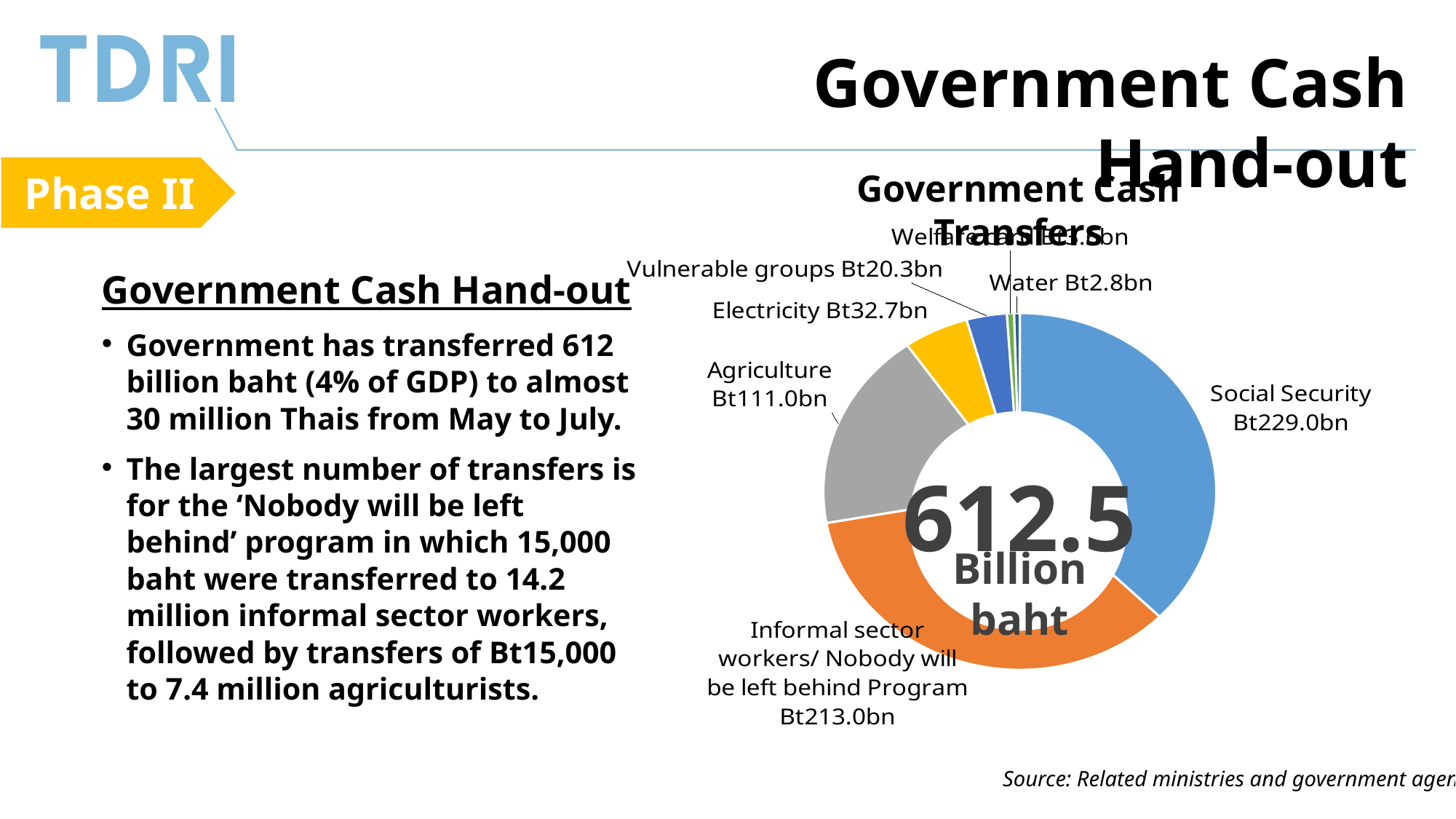
What is the value for Agriculture in the chart? Bt111.0bn What is the value for Electricity in the chart? Bt32.7bn What is the difference between Social Security and the Informal sector workers/ Nobody will be left behind Program? Bt16.0bn What is the value for Vulnerable groups in the chart? Bt20.3bn What type of chart is shown on the slide? Doughnut (pie) chart What is the title of the chart? Government Cash Transfers What is the value for Social Security in the chart? Bt229.0bn What is the value for Water in the chart? Bt2.8bn What is the value for the Informal sector workers/ Nobody will be left behind Program in the chart? Bt213.0bn Which is larger, Agriculture or Electricity? Agriculture What total is shown in the centre of the doughnut chart? 612.5 Billion baht Which category has the largest value in the chart? Social Security